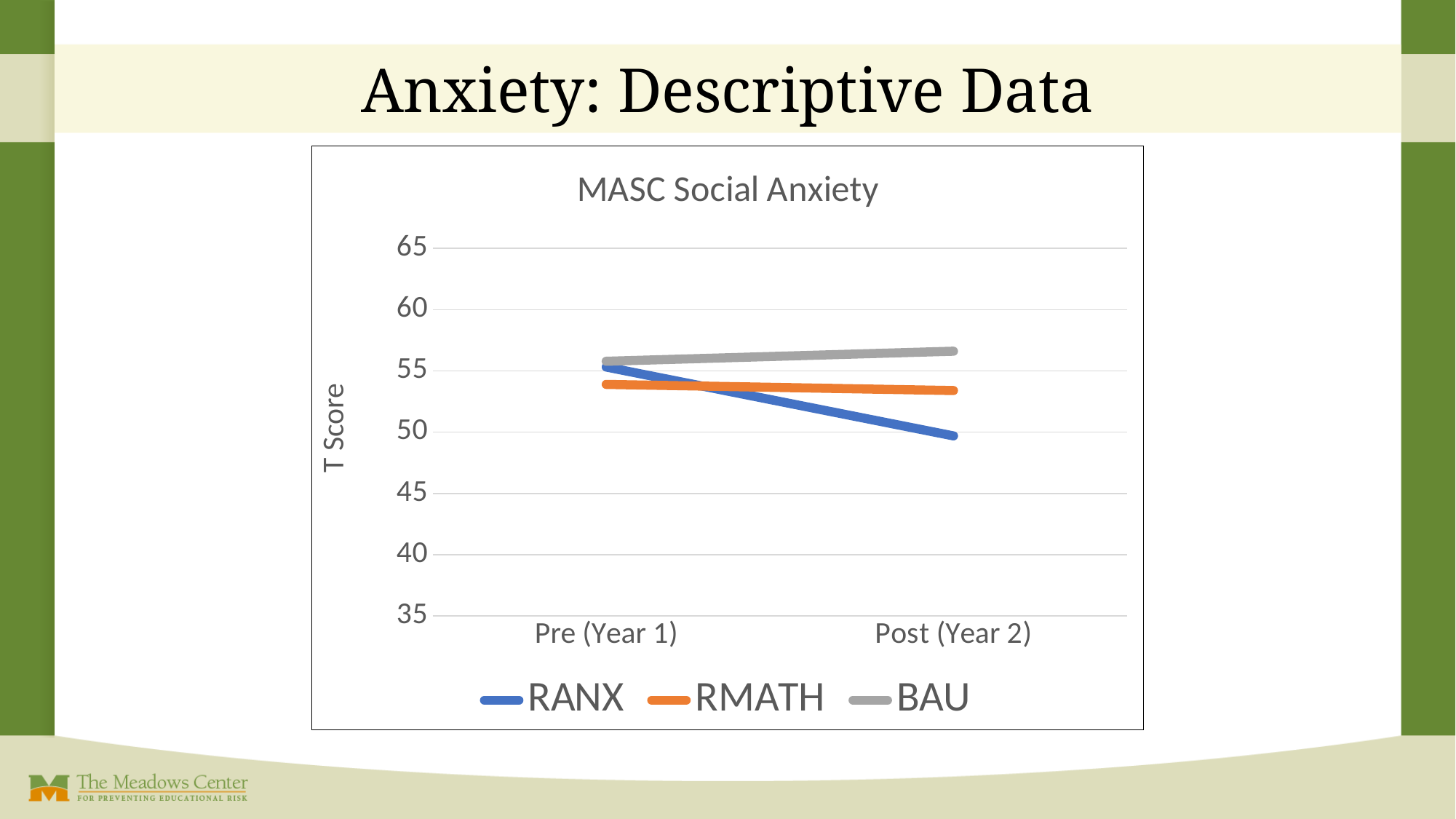
Does the BAU line rise or fall from Pre (Year 1) to Post (Year 2)? rise Is the value for BAU at Post (Year 2) greater or less than 55? greater What kind of chart is shown on the slide? line chart How many series does the legend list? 3 Does the RANX line rise or fall from Pre (Year 1) to Post (Year 2)? fall Is the value for RANX at Post (Year 2) greater or less than 55? less How many time points are shown on the x axis? 2 What is the label of the y axis? T Score Which series has the lowest value at Post (Year 2)? RANX What is the title of the chart? MASC Social Anxiety At Post (Year 2), which is larger, RMATH or RANX? RMATH Which series has the highest value at Post (Year 2)? BAU